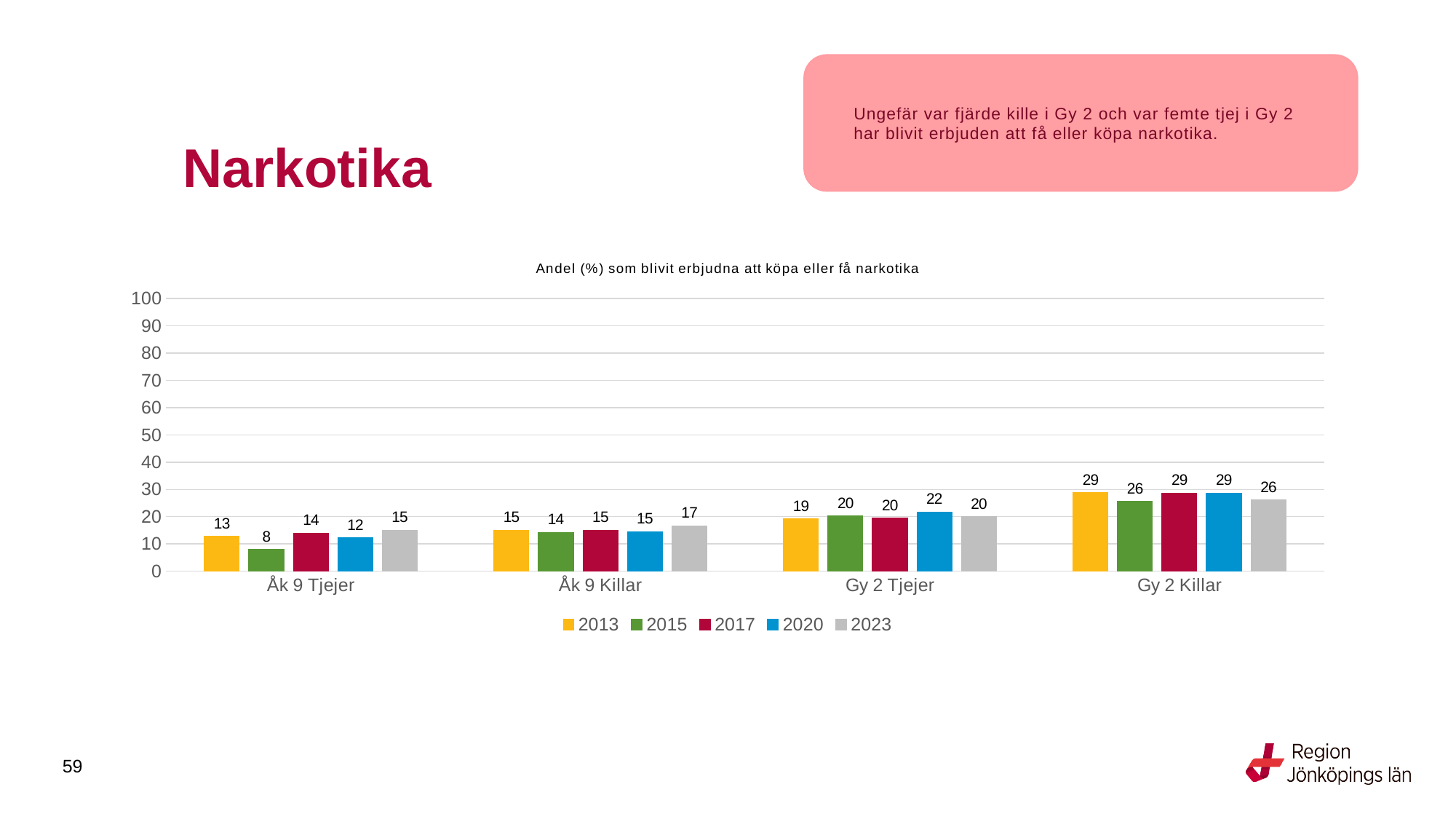
Is the value for Gy 2 Killar in 2020 greater or less than 20? greater What is the difference between Gy 2 Killar and Gy 2 Tjejer in 2017? 9 What is the value for Gy 2 Killar in 2023? 26 Which is larger in 2023: Åk 9 Killar or Gy 2 Tjejer? Gy 2 Tjejer Which category has the lowest value in 2015? Åk 9 Tjejer What is the value for Gy 2 Tjejer in 2020? 22 What kind of chart is shown on the slide? Bar chart How many series does the legend list? 5 Which category has the highest value in 2013? Gy 2 Killar What is the title of the chart? Andel (%) som blivit erbjudna att köpa eller få narkotika What is the value for Åk 9 Tjejer in 2015? 8 How many categories are shown on the x axis? 4